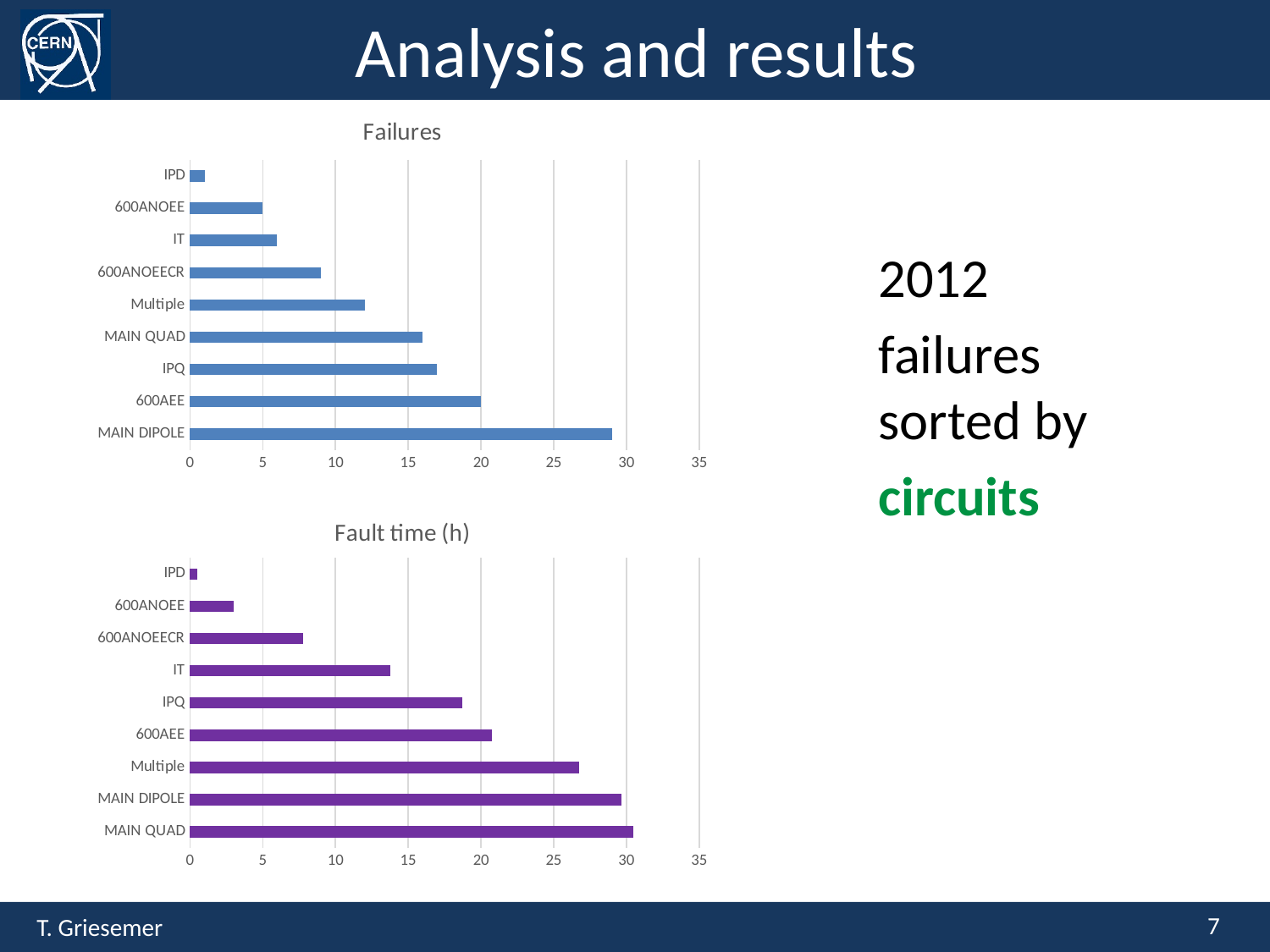
What is the title of the bottom chart on the slide? Fault time (h) In the 'Failures' chart, is the value for Multiple greater or less than 15? less In the 'Fault time (h)' chart, is the value for 600ANOEECR greater or less than 10? less In the 'Failures' chart, how many circuits are listed? 9 In the 'Failures' chart, which circuit has the highest number of failures? MAIN DIPOLE In the 'Failures' chart, which has more failures, Multiple or IT? Multiple In the 'Fault time (h)' chart, which has a larger fault time, Multiple or IT? Multiple In the 'Failures' chart, which circuit has the lowest number of failures? IPD In the 'Failures' chart, is the value for MAIN DIPOLE greater or less than 25? greater In the 'Fault time (h)' chart, which circuit has the lowest fault time? IPD What type of chart is the 'Failures' chart? bar chart